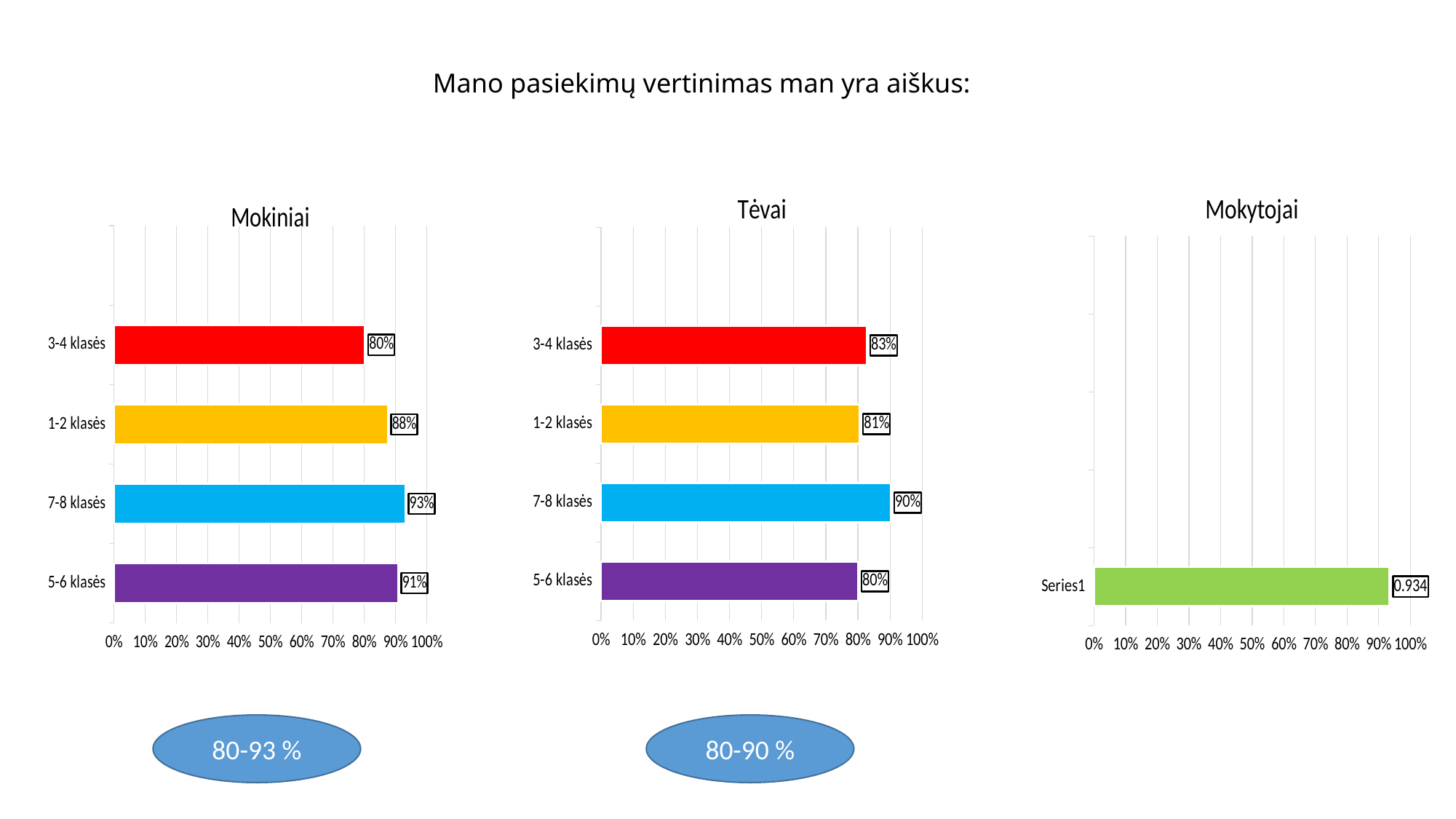
In the Tėvai chart, which is larger: the value for 3-4 klasės or the value for 5-6 klasės? 3-4 klasės In the Tėvai chart, which category has the lowest value? 5-6 klasės What type of chart is the Mokiniai chart? Bar chart In the Mokytojai chart, what is the value for Series1? 0.934 In the Mokiniai chart, which category has the highest value? 7-8 klasės In the Mokiniai chart, what is the value for 3-4 klasės? 80% How many categories are shown in the Tėvai chart? 4 In the Mokiniai chart, what is the value for 7-8 klasės? 93% What is the title of the chart on the right of the slide? Mokytojai In the Tėvai chart, what is the value for 1-2 klasės? 81% In the Tėvai chart, what is the difference between the values for 7-8 klasės and 1-2 klasės? 9% In the Mokiniai chart, what is the difference between the values for 7-8 klasės and 3-4 klasės? 13%